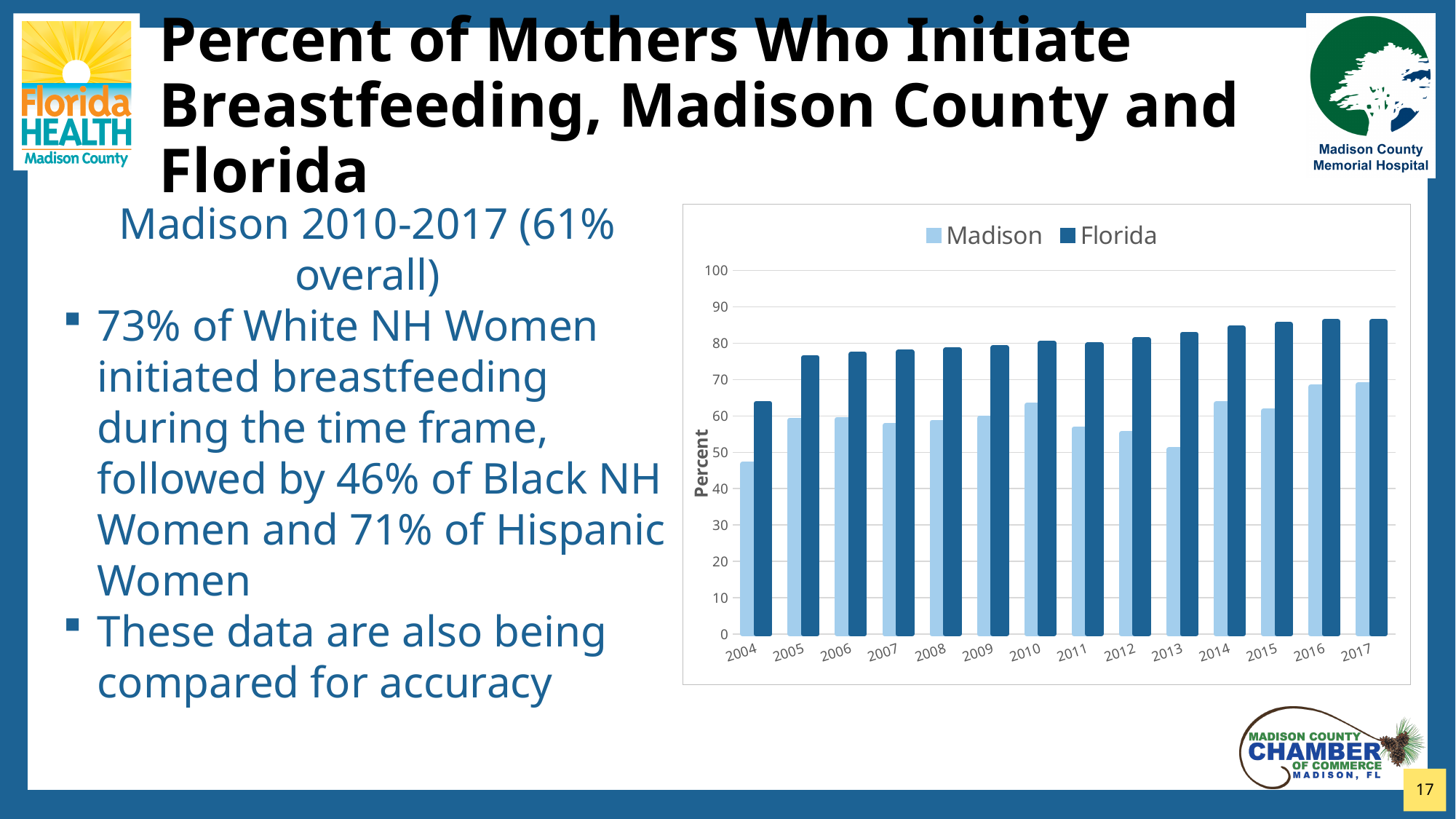
Is the Madison value for 2012 greater or less than 60? less How many years are shown on the x axis of the chart? 14 Is the Madison value for 2004 greater or less than 50? less How many series does the chart legend list? 2 What kind of chart is shown on the slide? bar chart Do the Florida values generally rise or fall from 2004 to 2017? rise Which is larger, the Madison value for 2004 or the Madison value for 2005? 2005 Is the Florida value for 2017 greater or less than 80? greater Which year has the lowest Madison value in the chart? 2004 Which year has the lowest Florida value in the chart? 2004 In 2017, which series has the larger value, Madison or Florida? Florida